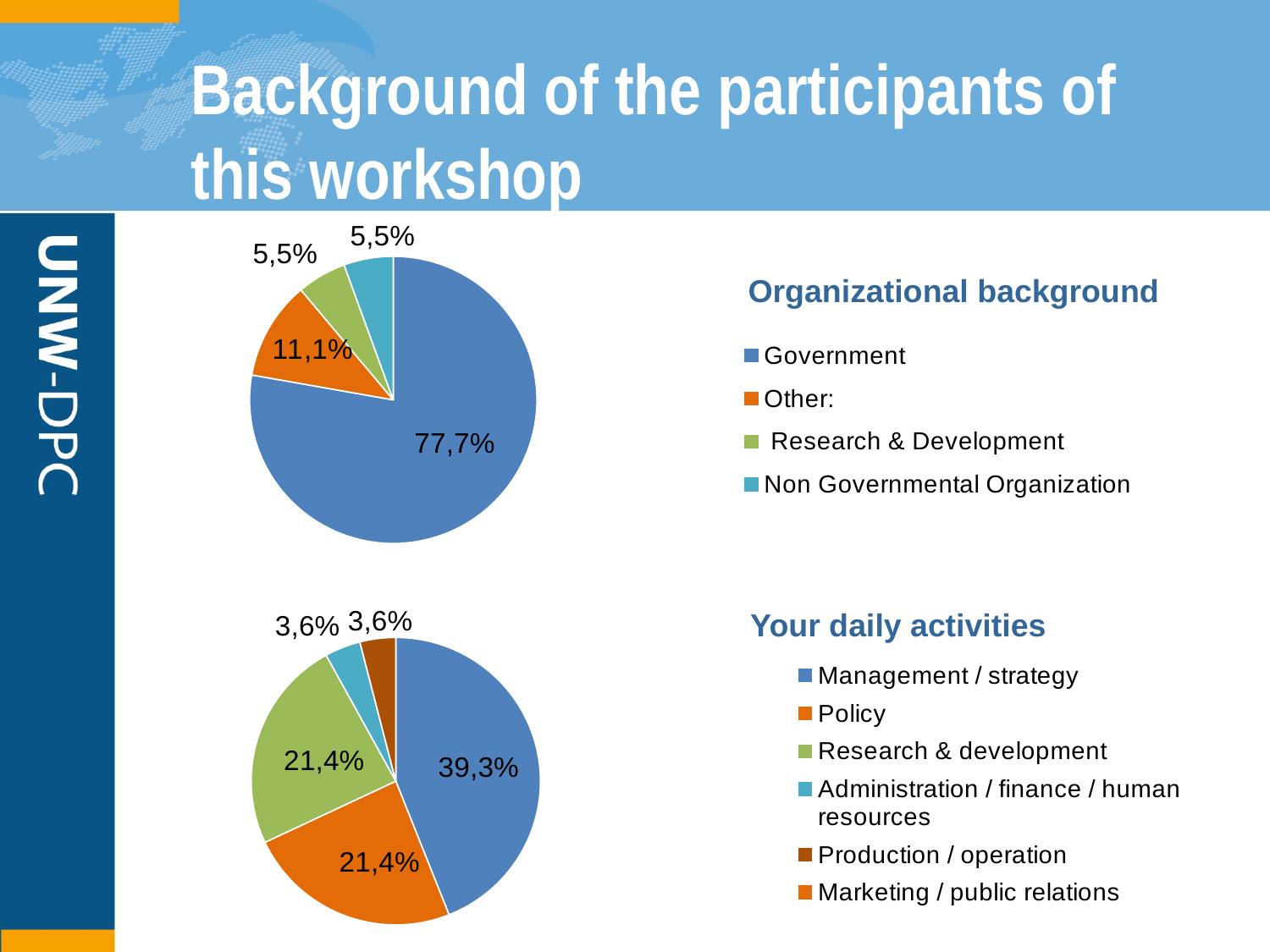
In the 'Organizational background' pie chart, what is the difference between the Government share and the 'Other:' share? 66,6% In the 'Organizational background' pie chart, what share of participants come from Government? 77,7% In the 'Your daily activities' pie chart, what share is labelled for Management / strategy? 39,3% What type of chart is used for 'Organizational background'? Pie chart How many entries does the legend of the 'Organizational background' chart list? 4 In the 'Your daily activities' pie chart, what is the share for Policy? 21,4% In the 'Your daily activities' pie chart, is the share for Management / strategy larger or smaller than the share for Policy? Larger In the 'Your daily activities' pie chart, what is the difference between the Management / strategy share and the Research & development share? 17,9% In the 'Organizational background' pie chart, which category has the largest share? Government In the 'Your daily activities' pie chart, which category has the largest share? Management / strategy In the 'Organizational background' pie chart, what is the share for 'Other:'? 11,1% How many entries does the legend of the 'Your daily activities' chart list? 6